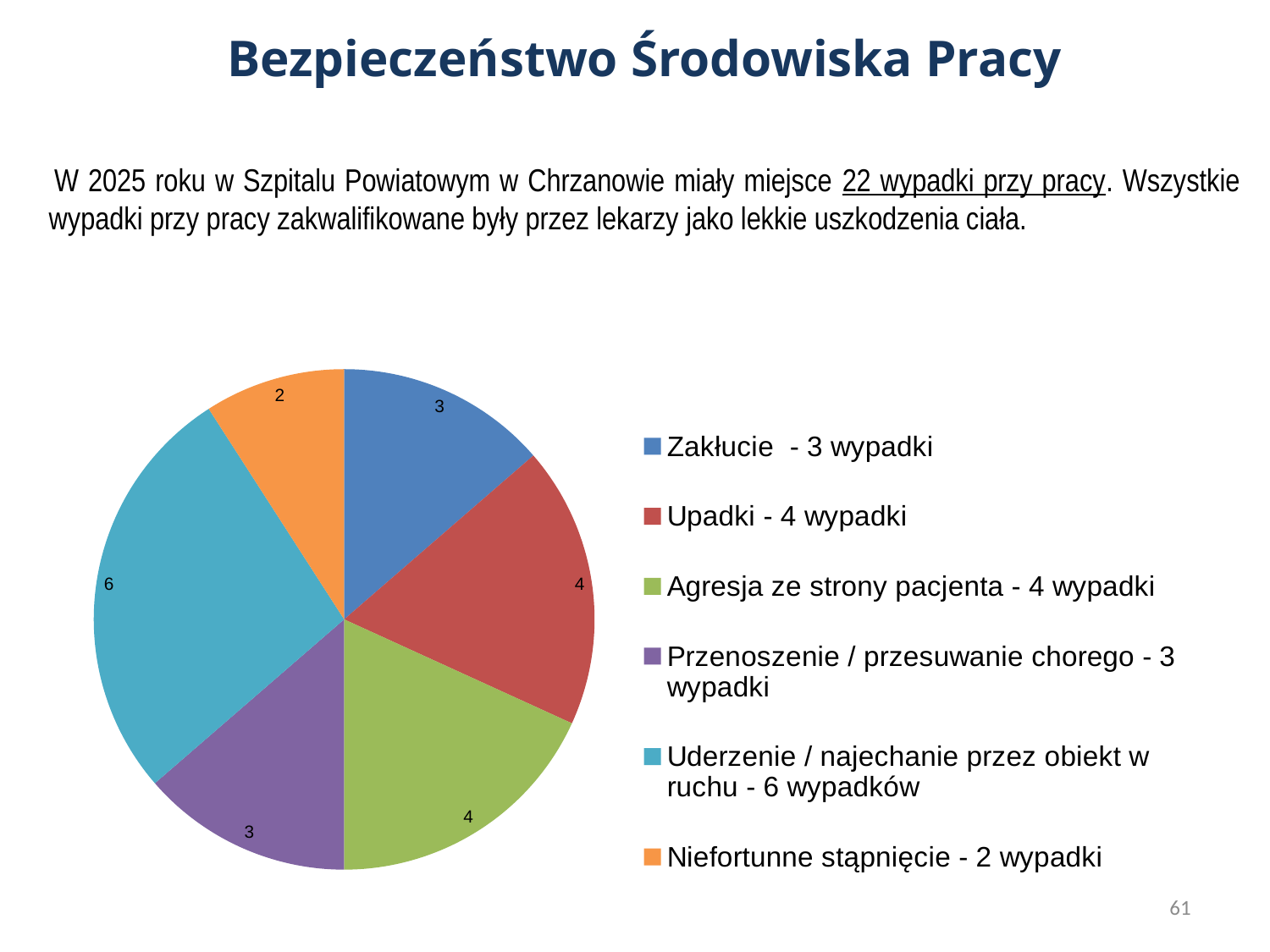
Which category has the smallest slice of the pie? Niefortunne stąpnięcie How many accidents are shown for Niefortunne stąpnięcie? 2 Which category has the largest slice of the pie? Uderzenie / najechanie przez obiekt w ruchu How many accidents are shown for Zakłucie? 3 What is the difference between the number of accidents for Uderzenie / najechanie przez obiekt w ruchu and Niefortunne stąpnięcie? 4 How many accidents are shown for Uderzenie / najechanie przez obiekt w ruchu? 6 What colour is the slice for Agresja ze strony pacjenta? green What is the total number of accidents across all slices of the pie? 22 What kind of chart is shown on the slide? pie chart Which has more accidents, Upadki or Zakłucie? Upadki How many slices does the pie chart have? 6 How many accidents are shown for Upadki? 4